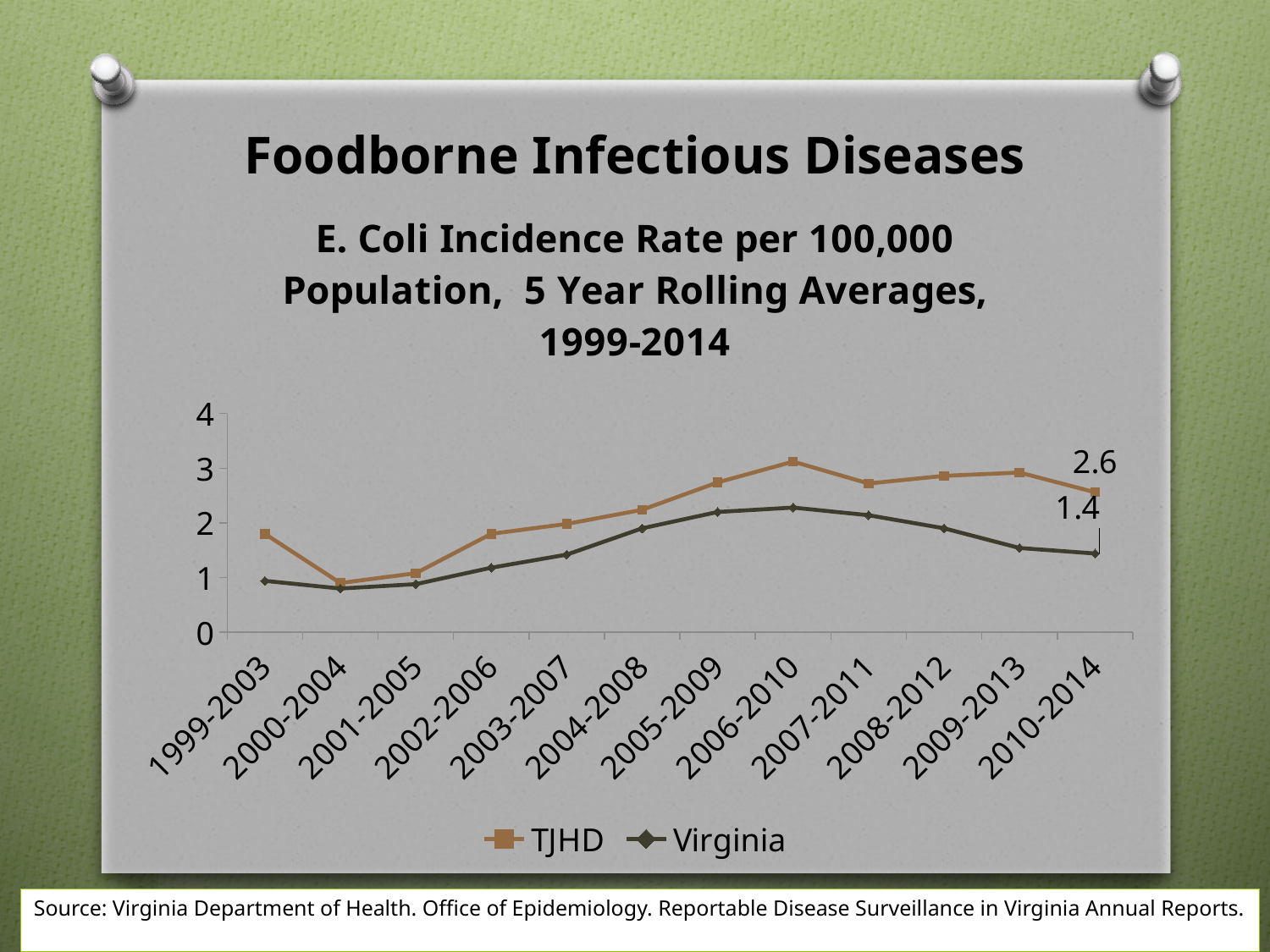
Is the Virginia value for 2006-2010 greater or less than 2? greater For 2010-2014, which series has the larger value, TJHD or Virginia? TJHD Does the Virginia series rise or fall from 2006-2010 to 2010-2014? fall What is the difference between the TJHD and Virginia values for 2010-2014? 1.2 What kind of chart is shown on the slide? line chart Is the TJHD value for 2005-2009 greater or less than 2? greater Is the TJHD value for 1999-2003 greater or less than 2? less In which period does the TJHD series reach its highest value? 2006-2010 How many periods are shown on the x axis? 12 How many series does the legend list? 2 What is the Virginia value for 2010-2014? 1.4 What is the TJHD value for 2010-2014? 2.6